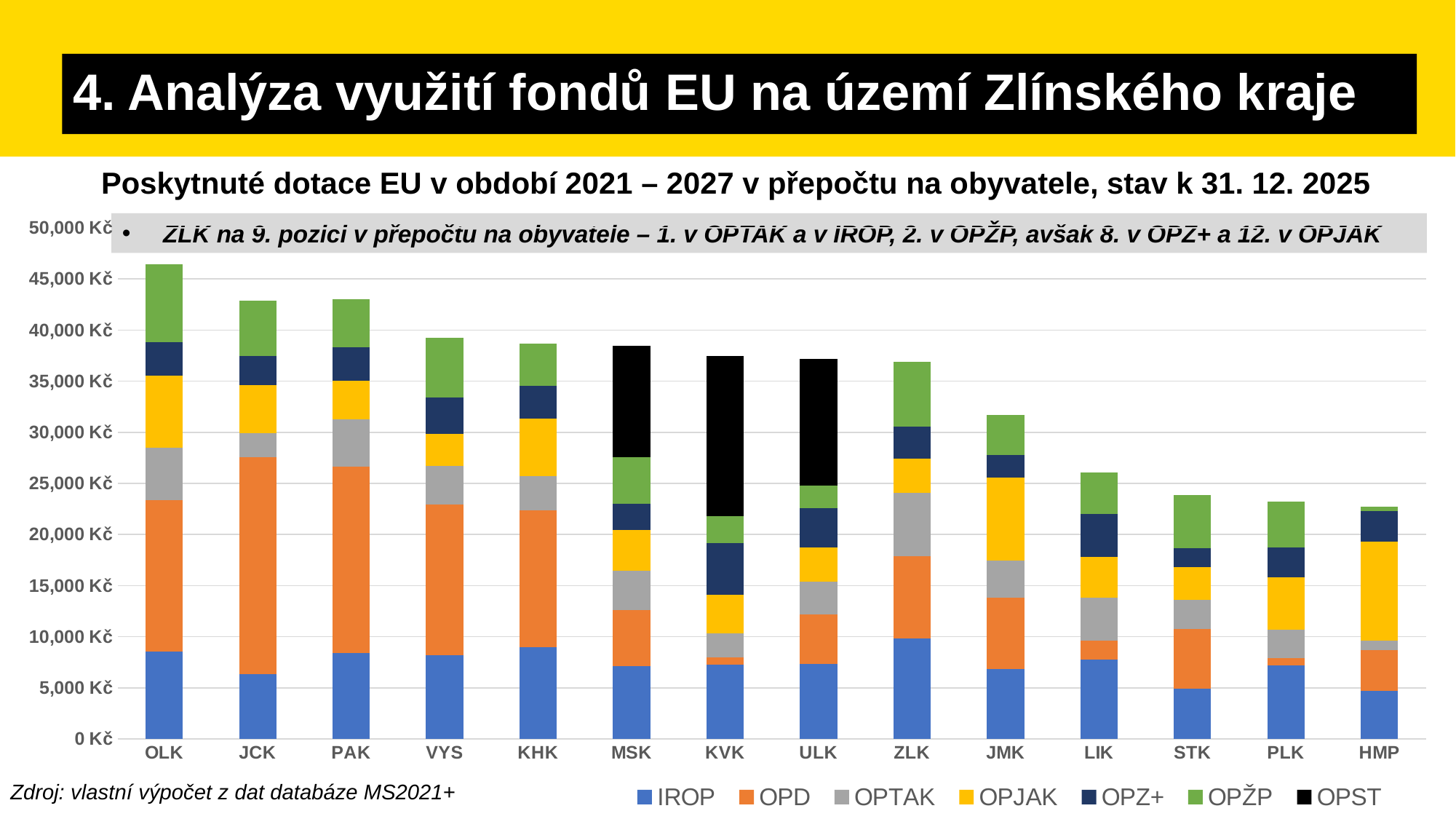
Is the total value for JMK greater or less than 35,000 Kč? less Which region has the highest total bar in the chart? OLK How many series does the chart legend list? 7 Is the total value for HMP greater or less than 25,000 Kč? less Is the total value for ZLK greater or less than 35,000 Kč? greater What is the title of the chart? Poskytnuté dotace EU v období 2021 – 2027 v přepočtu na obyvatele, stav k 31. 12. 2025 How many regions (categories) are shown on the x axis of the chart? 14 Which has the larger total bar, ZLK or JMK? ZLK Do the total bar values generally rise or fall from left to right along the x axis? fall How many regions have a black OPST segment in their bar? 3 What kind of chart is shown on the slide? stacked bar chart